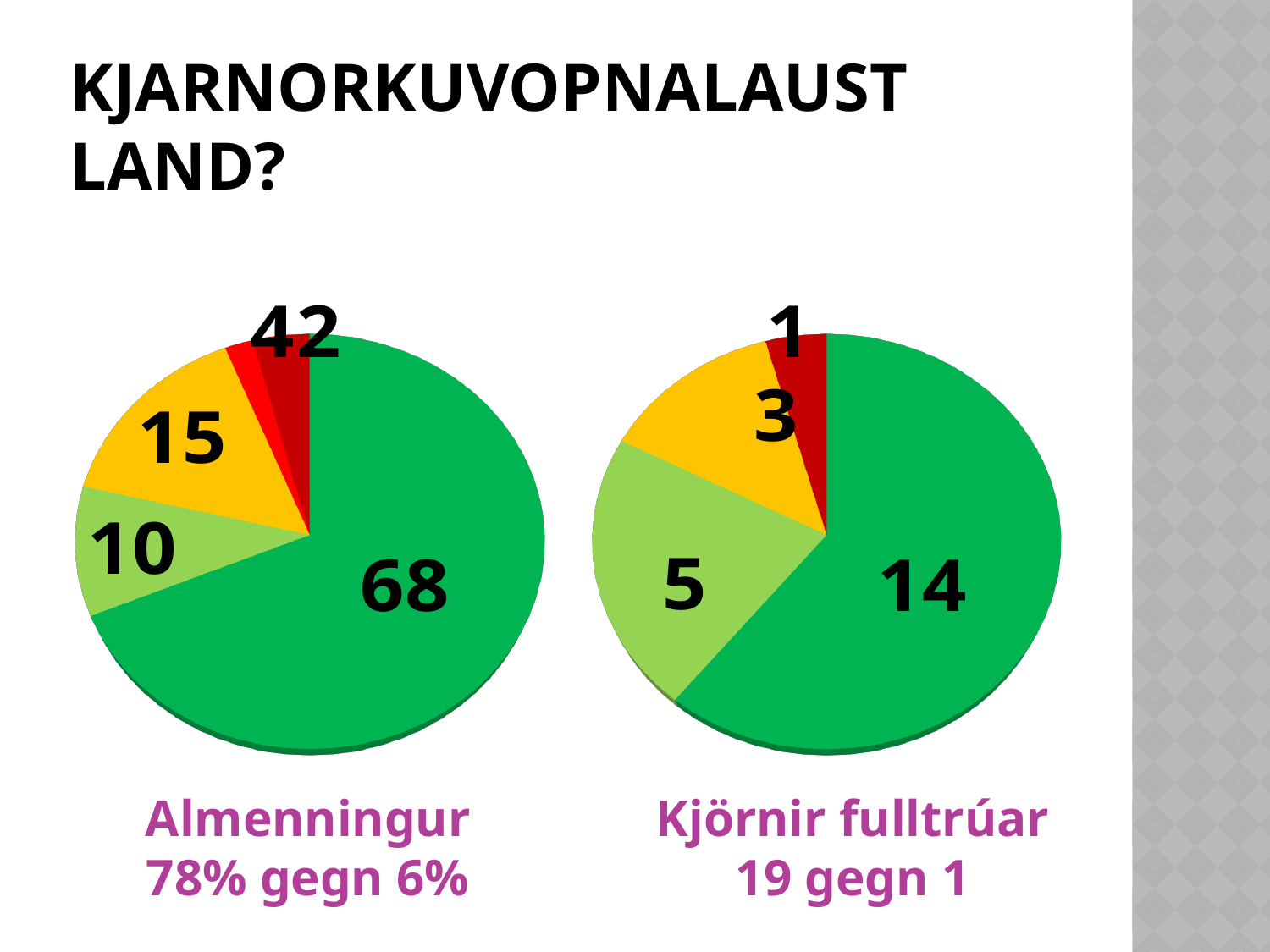
In the Almenningur pie chart, what is the value of the largest (dark green) slice? 68 In the Almenningur pie chart, what is the value of the light green slice? 10 In the Kjörnir fulltrúar pie chart, what is the value of the light green slice? 5 In the Kjörnir fulltrúar pie chart, what is the difference between the dark green slice and the light green slice? 9 What kind of charts are shown on the slide? Pie charts In the Kjörnir fulltrúar pie chart, what is the value of the largest (dark green) slice? 14 In the Kjörnir fulltrúar pie chart, what is the value of the smallest slice? 1 In the Kjörnir fulltrúar pie chart, what is the value of the yellow slice? 3 In the Almenningur pie chart, which is larger: the yellow slice or the light green slice? The yellow slice How many pie charts are on the slide? 2 In the Almenningur pie chart, what is the value of the yellow slice? 15 How many slices does the Kjörnir fulltrúar pie chart have? 4